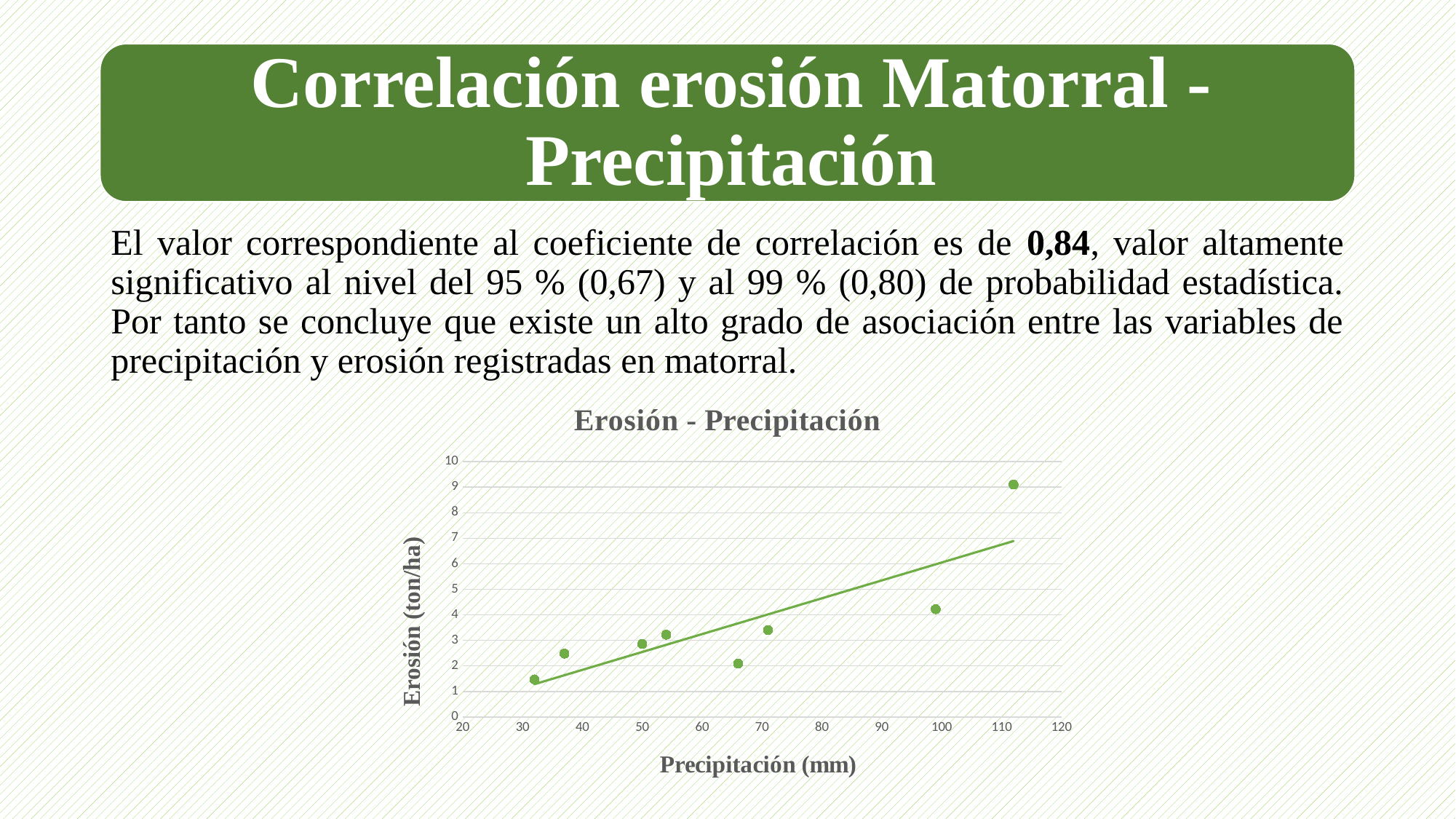
Is the erosion value for the point with the highest precipitation (around 112 mm) greater or less than 8 ton/ha? greater Which point has the lowest erosion value: the one at about 32 mm or the one at about 66 mm of precipitation? The one at about 32 mm Is the erosion value for the point with the lowest precipitation (around 32 mm) greater or less than 2 ton/ha? less Is the erosion value for the point at about 99 mm of precipitation greater or less than 5 ton/ha? less Does erosion generally rise or fall as precipitation increases along the x axis? Rise What is the title of the chart? Erosión - Precipitación How many data points are plotted in the chart? 8 What kind of chart is shown on the slide? Scatter chart What is the label of the vertical axis of the chart? Erosión (ton/ha) Which point has the highest erosion value: the one at about 112 mm or the one at about 99 mm of precipitation? The one at about 112 mm What is the maximum value shown on the vertical axis of the chart? 10